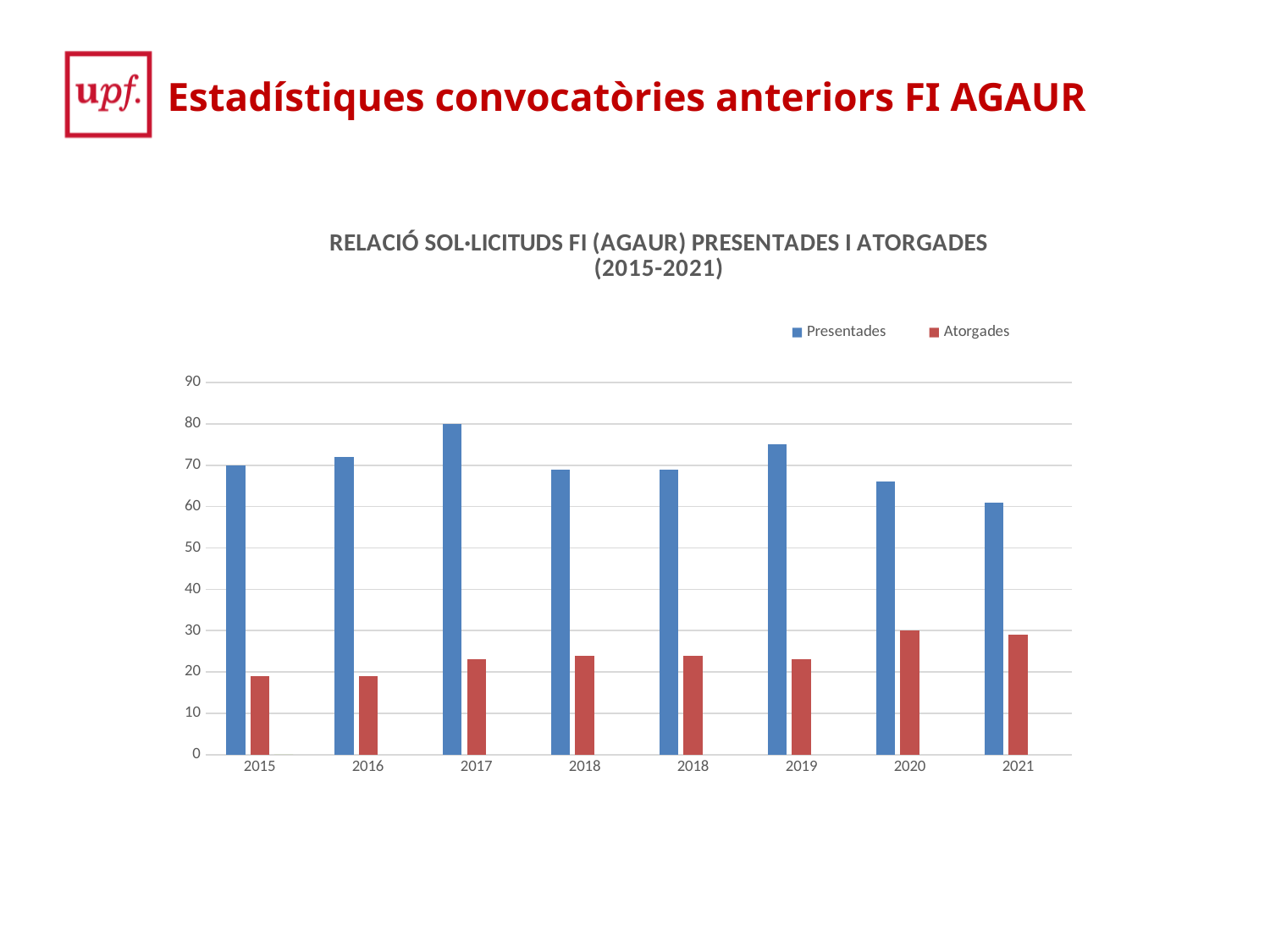
Which year has the lowest value for Presentades? 2021 What is the value of Presentades for 2017? 80 What is the value of Presentades for 2015? 70 How many year categories are shown on the x axis? 8 How many series does the legend list? 2 Which is larger, Presentades for 2017 or Presentades for 2019? Presentades for 2017 Is the value of Atorgades for 2017 greater or less than 20? greater What is the value of Atorgades for 2020? 30 What are the two series named in the legend? Presentades and Atorgades Which year has the highest value for Presentades? 2017 What kind of chart is shown on the slide? bar chart Is the value of Presentades for 2019 greater or less than 70? greater